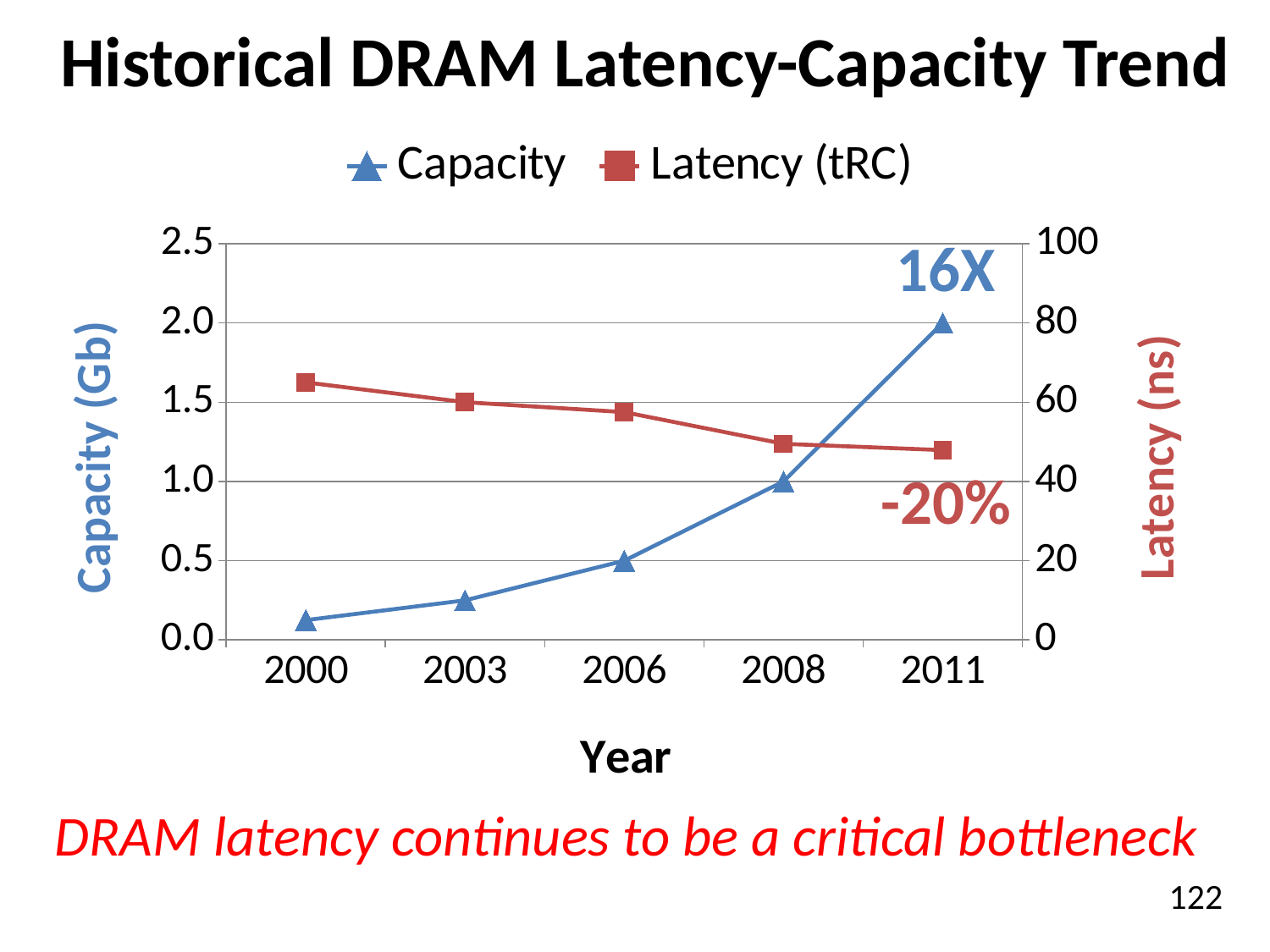
What is the Capacity value for 2008? 1.0 Is the Capacity value for 2000 greater or less than 0.5? less How many years are plotted along the x axis? 5 Is the Latency (tRC) value for 2000 greater or less than 60? greater How many series does the legend list? 2 What is the title of the chart? Historical DRAM Latency-Capacity Trend In which year is Latency (tRC) highest? 2000 What is the Capacity value for 2011? 2.0 Does Latency (tRC) rise or fall from 2000 to 2011? fall In which year is Capacity highest? 2011 What kind of chart is shown on the slide? line chart In which year is Latency (tRC) lowest? 2011